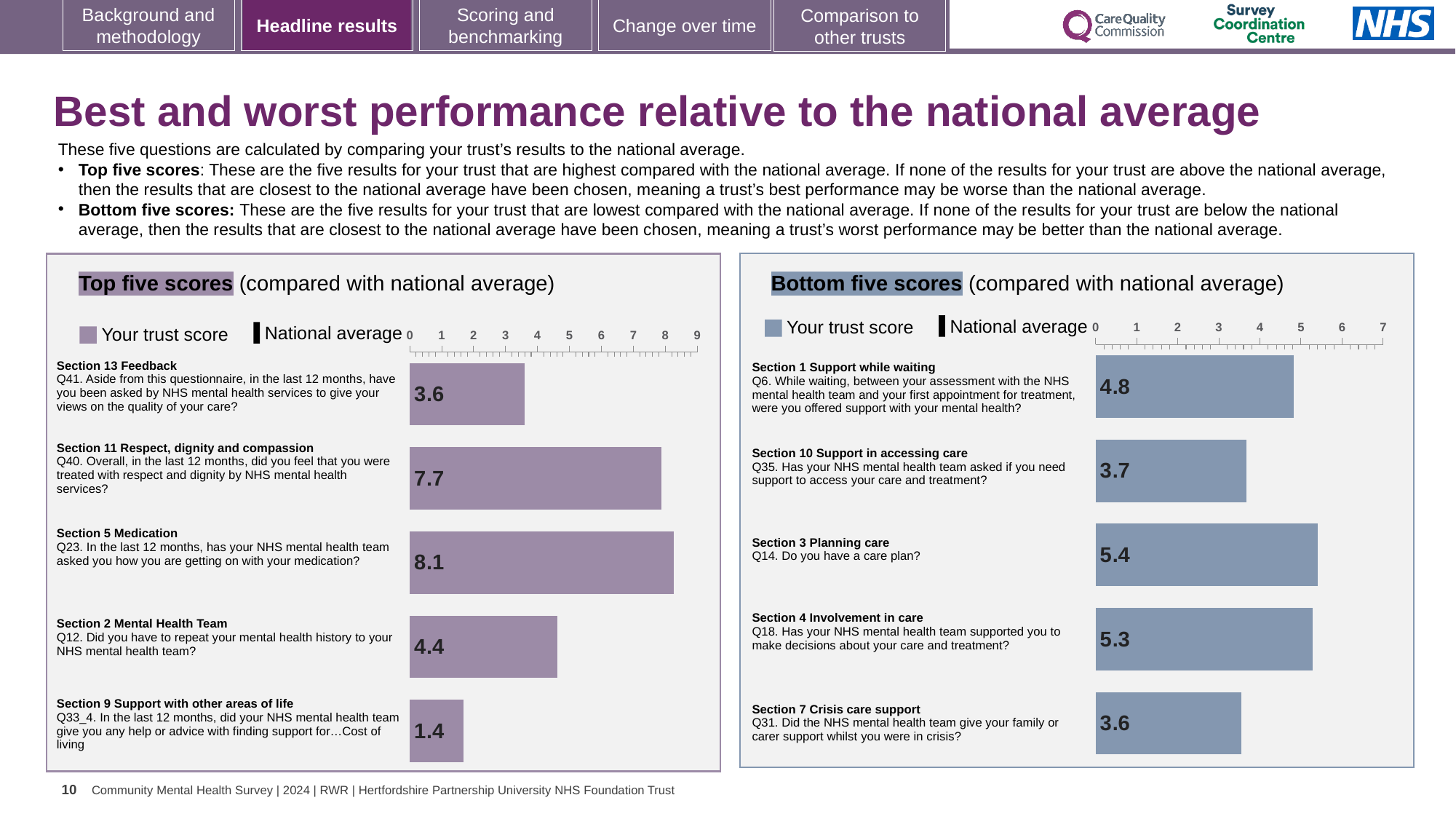
What type of chart is the Top five scores chart? Bar chart In the Bottom five scores chart, which section has the highest trust score? Section 3 Planning care In the Top five scores chart, how many questions are plotted? 5 In the Bottom five scores chart, what is the trust score for Section 1 Support while waiting (Q6)? 4.8 In the Top five scores chart, what is the trust score for Section 5 Medication (Q23)? 8.1 In the Top five scores chart, what is the trust score for Section 9 Support with other areas of life (Q33_4)? 1.4 In the Top five scores chart, what is the difference between the trust scores for Section 11 Respect, dignity and compassion and Section 2 Mental Health Team? 3.3 In the Top five scores chart, which section has the highest trust score? Section 5 Medication In the Bottom five scores chart, what is the trust score for Section 7 Crisis care support (Q31)? 3.6 In the Top five scores chart, which section has the lowest trust score? Section 9 Support with other areas of life In the Bottom five scores chart, what is the difference between the trust scores for Section 3 Planning care and Section 7 Crisis care support? 1.8 In the Bottom five scores chart, which is larger, the trust score for Section 1 Support while waiting or for Section 10 Support in accessing care? Section 1 Support while waiting